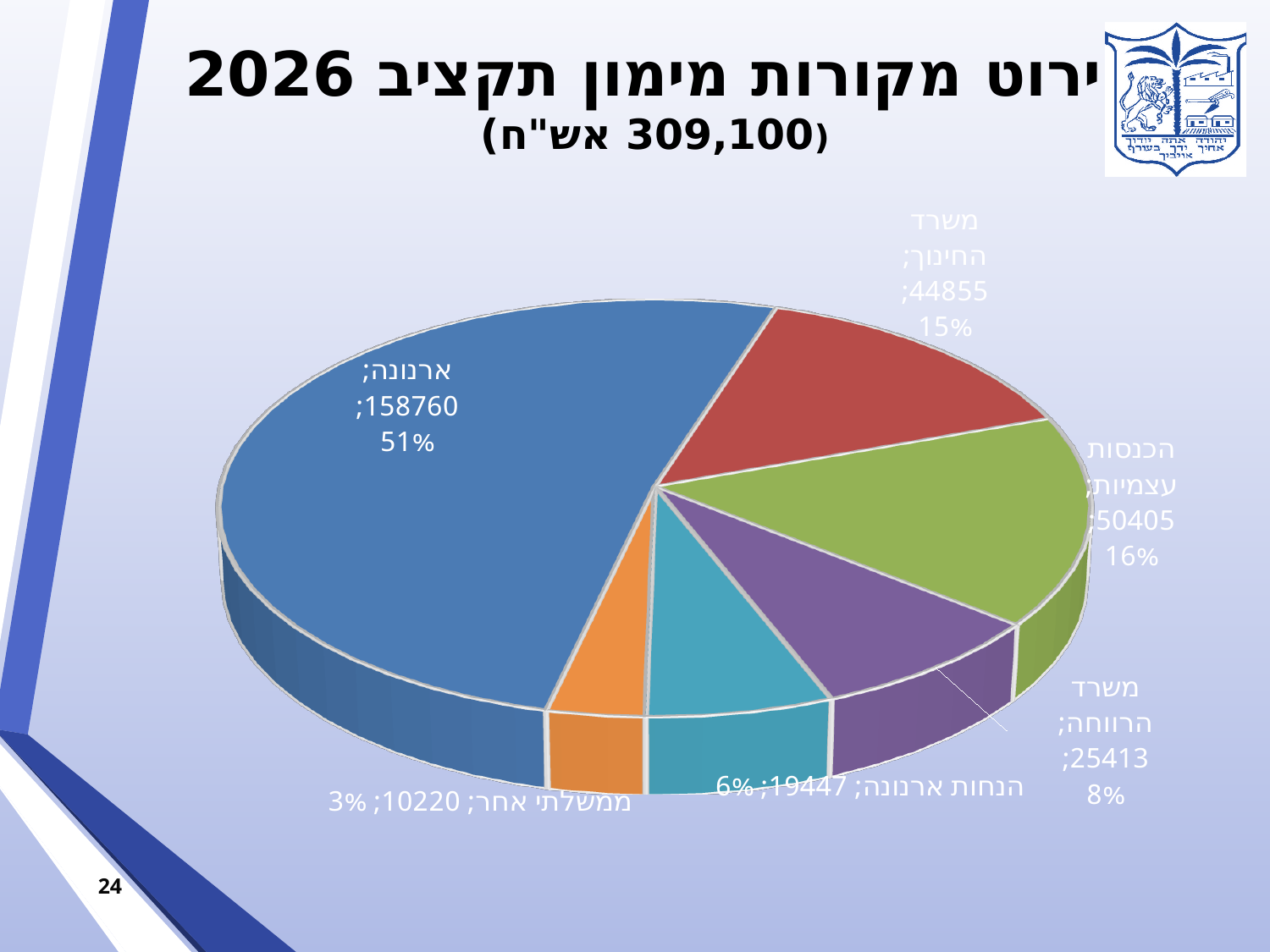
What is the difference between the values for הכנסות עצמיות and משרד החינוך? 5550 What is the value shown for הכנסות עצמיות? 50405 What kind of chart is shown on the slide? Pie chart What is the value shown for משרד הרווחה? 25413 How many slices does the pie chart have? 6 What is the value shown for ארנונה? 158760 Which category has the smallest slice of the pie? ממשלתי אחר Which is larger, הכנסות עצמיות or משרד החינוך? הכנסות עצמיות Which category has the largest slice of the pie? ארנונה What percentage share of the pie does ממשלתי אחר have? 3% What percentage share of the pie does הנחות ארנונה have? 6% What is the value shown for משרד החינוך? 44855